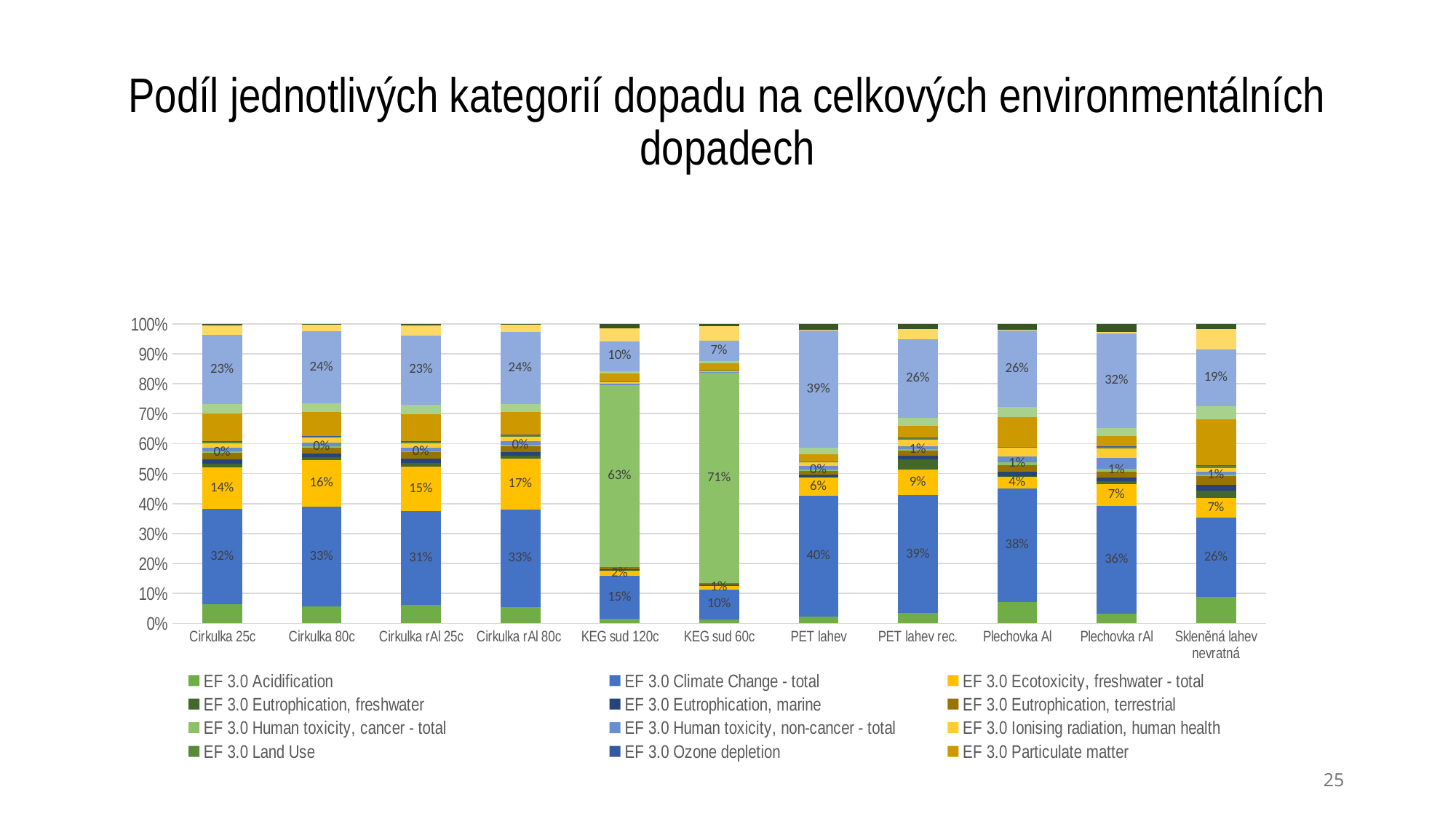
How many series does the legend list? 12 What is the difference in the EF 3.0 Ecotoxicity, freshwater - total share between Cirkulka rAl 80c and Cirkulka 25c? 3 percentage points How many packaging categories are shown along the x axis? 11 What is the share of EF 3.0 Climate Change - total for PET lahev? 40% Which category has the lowest share of EF 3.0 Climate Change - total? KEG sud 60c What kind of chart is shown on the slide? Stacked bar chart Which category has the highest share of EF 3.0 Climate Change - total? PET lahev What is the share of EF 3.0 Ecotoxicity, freshwater - total for Plechovka Al? 4% What is the title of the slide? Podíl jednotlivých kategorií dopadu na celkových environmentálních dopadech